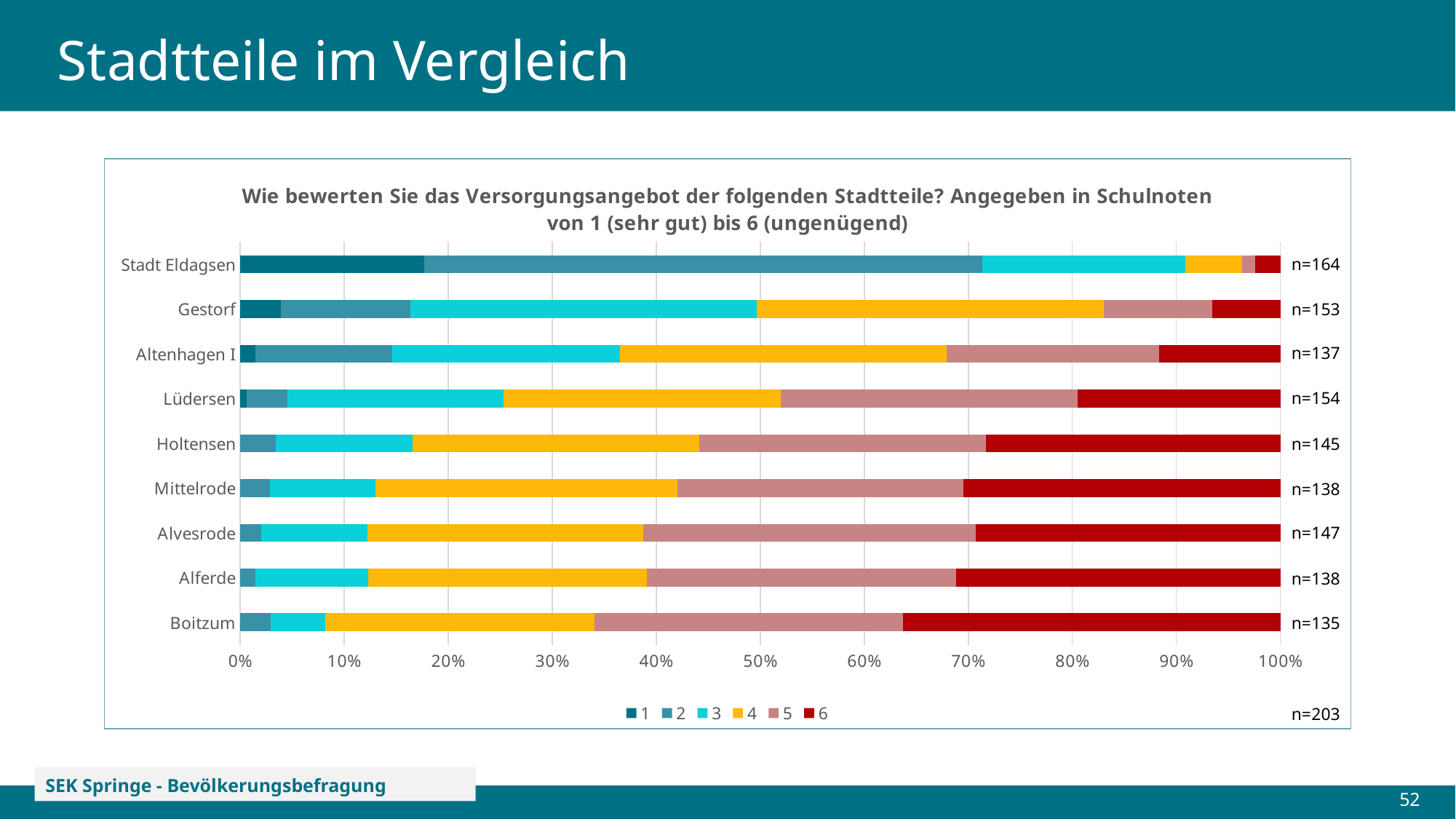
How many Stadtteile (categories) are plotted in the chart? 9 What is the n value printed next to the bar for Stadt Eldagsen? n=164 What kind of chart is shown on the slide? Stacked bar chart How many series does the legend list? 6 What is the difference between the n values for Gestorf and Altenhagen I? 16 What is the first legend entry of the chart? 1 What is the n value printed next to the bar for Boitzum? n=135 Which Stadtteil has the highest n value printed next to its bar? Stadt Eldagsen Which Stadtteil has the lowest n value printed next to its bar? Boitzum What is the overall n value printed at the bottom right of the chart? n=203 Which Stadtteil has the larger share of grade 6 (dark red): Boitzum or Stadt Eldagsen? Boitzum Is the share of grade 6 (dark red) for Boitzum greater or less than 30%? greater